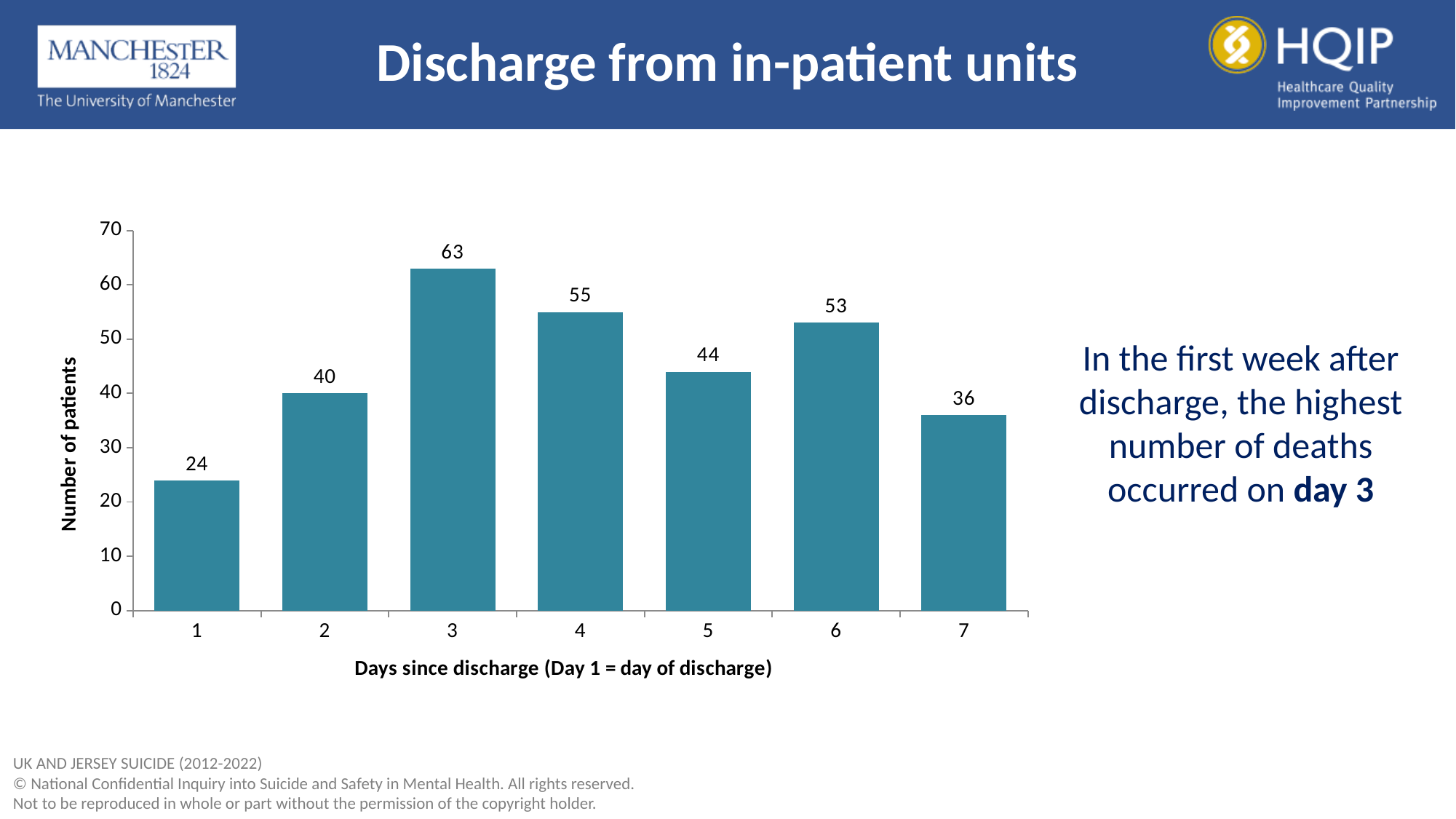
What is the difference in number of patients between day 6 and day 5? 9 What is the number of patients for day 7 since discharge? 36 What is the label of the y axis of the chart? Number of patients What kind of chart is shown on the slide? Bar chart What is the number of patients for day 1 since discharge? 24 Which has more patients, day 4 or day 6? Day 4 Is the value for day 2 greater or less than 30? greater Which day since discharge has the lowest number of patients? 1 How many days are shown on the x axis of the chart? 7 Which day since discharge has the highest number of patients? 3 What is the number of patients for day 3 since discharge? 63 What is the difference in number of patients between day 3 and day 1? 39